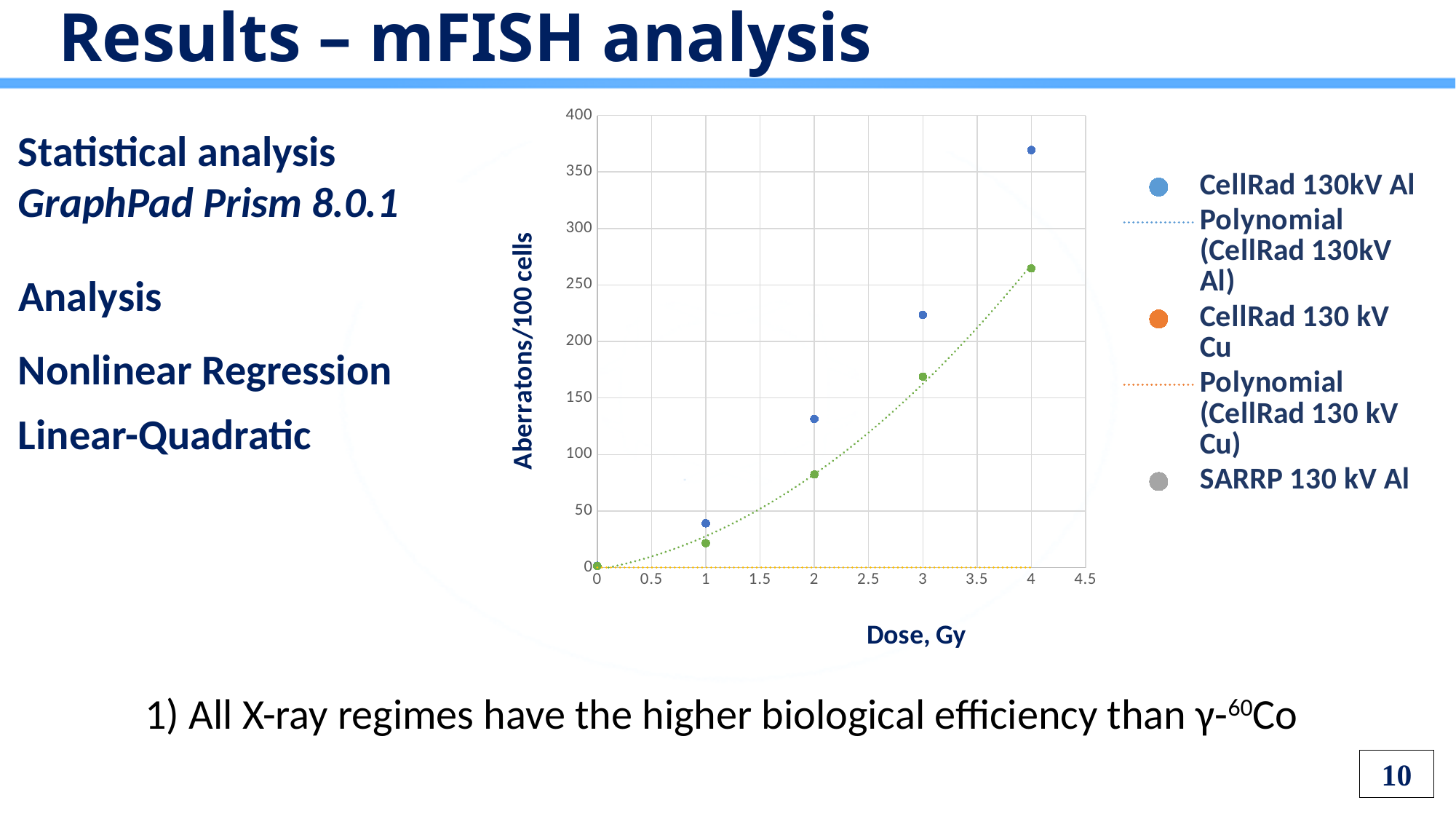
Is the value of the blue CellRad 130kV Al point at a dose of 2 Gy greater or less than 100? greater What kind of chart is shown on the slide? scatter chart Is the value of the green point at a dose of 4 Gy greater or less than 300? less Is the value of the blue CellRad 130kV Al point at a dose of 3 Gy greater or less than 200? greater Do the values of the blue CellRad 130kV Al points rise or fall as the dose increases? rise How many entries does the chart legend list? 5 At a dose of 4 Gy, which is higher: the blue CellRad 130kV Al point or the green point? the blue CellRad 130kV Al point What is the title of the x axis of the chart? Dose, Gy What is the title of the y axis of the chart? Aberratons/100 cells